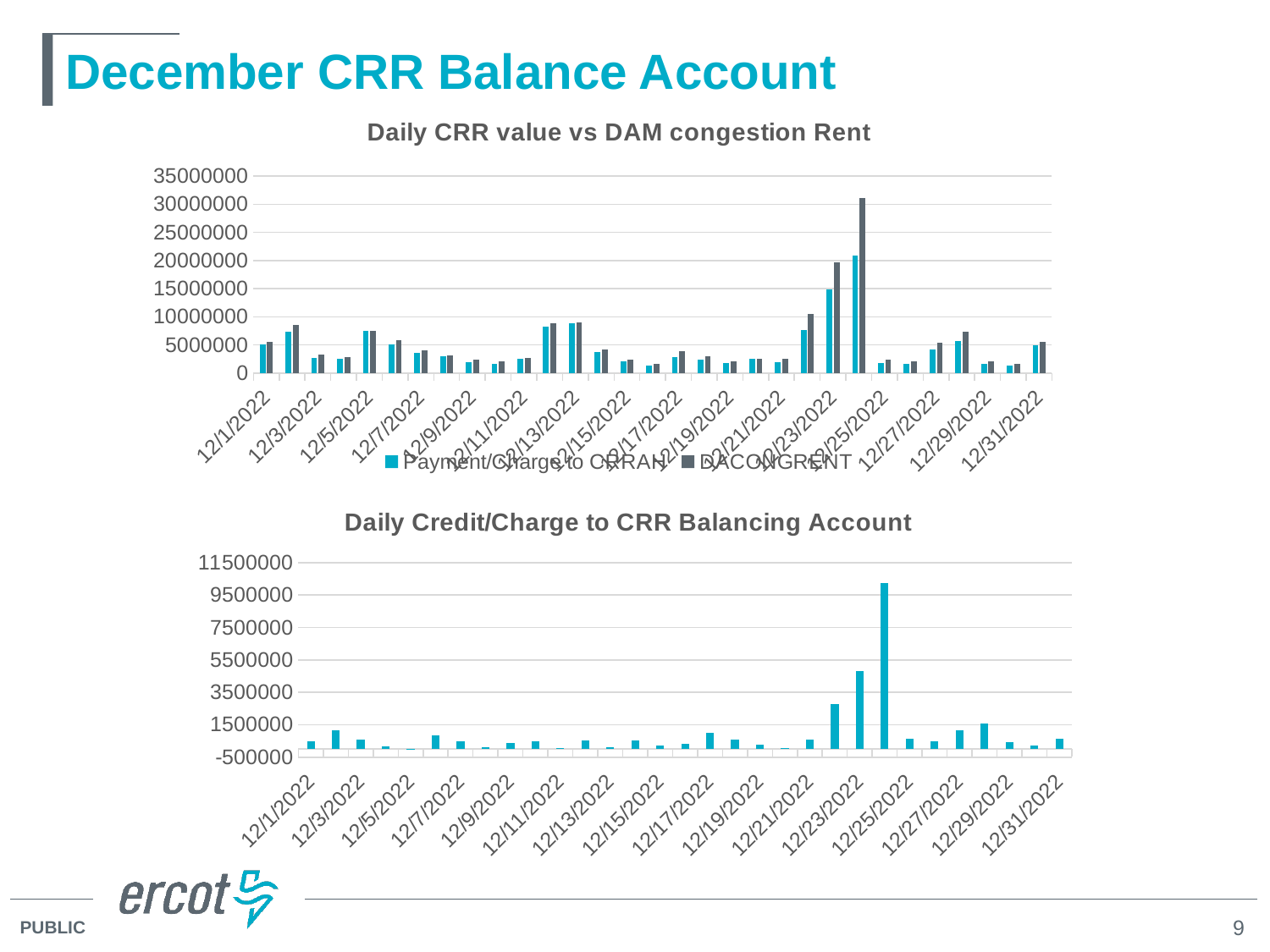
What kind of chart is the bottom chart titled "Daily Credit/Charge to CRR Balancing Account"? bar chart In the bottom chart "Daily Credit/Charge to CRR Balancing Account", is the highest value greater or less than 11500000? less In the top chart "Daily CRR value vs DAM congestion Rent", which series reaches the higher peak value, Payment/Charge to CRRAH or DACONGRENT? DACONGRENT What is the title of the bottom chart on the slide? Daily Credit/Charge to CRR Balancing Account What kind of chart is the top chart titled "Daily CRR value vs DAM congestion Rent"? bar chart In the top chart "Daily CRR value vs DAM congestion Rent", is the DACONGRENT value for 12/1/2022 greater or less than 10000000? less In the top chart "Daily CRR value vs DAM congestion Rent", is the highest Payment/Charge to CRRAH value greater or less than 25000000? less In the top chart "Daily CRR value vs DAM congestion Rent", what are the two series named in the legend? Payment/Charge to CRRAH and DACONGRENT In the top chart "Daily CRR value vs DAM congestion Rent", how many series does the legend list? 2